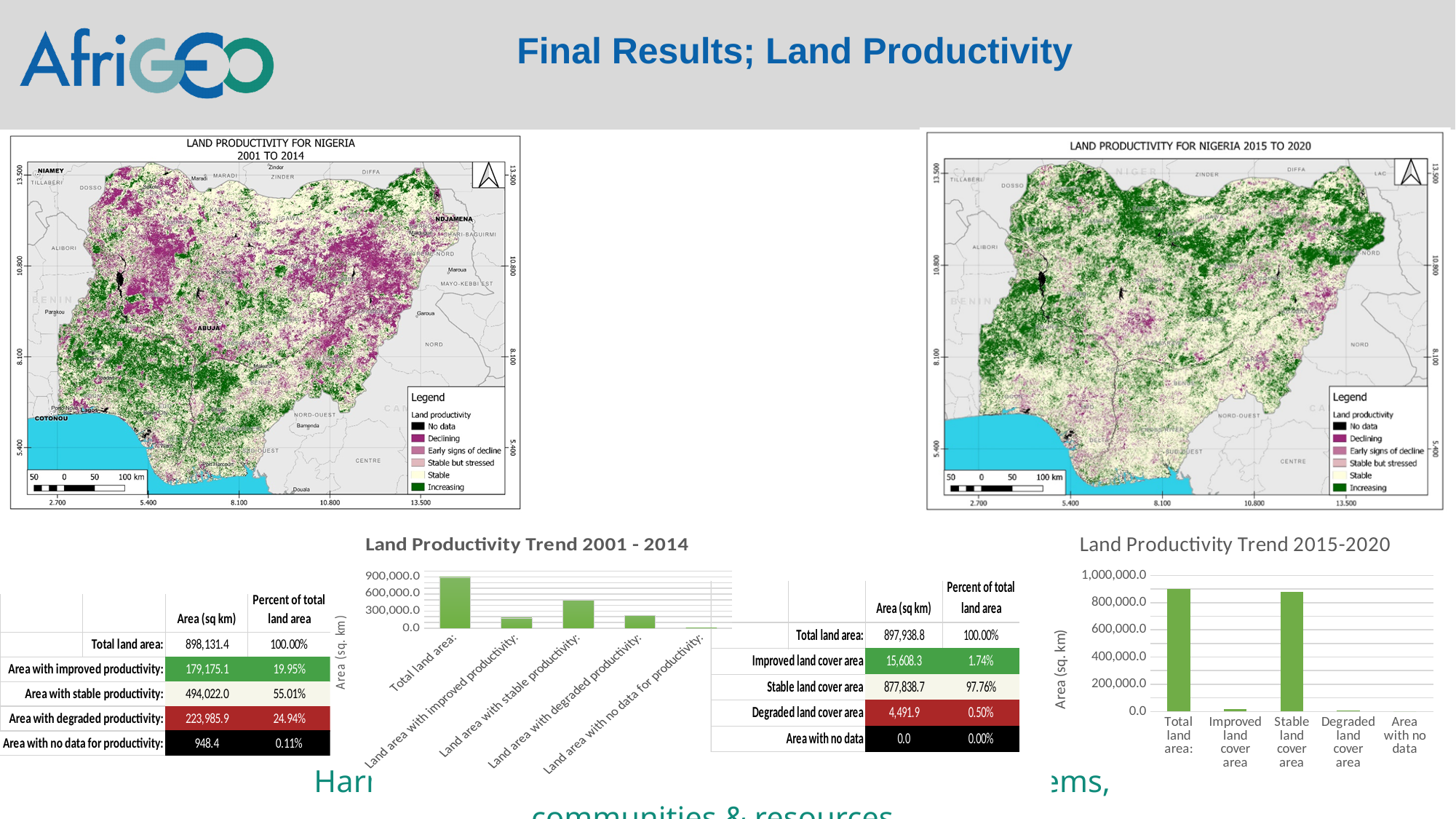
What is the y-axis label of the 'Land Productivity Trend 2001 - 2014' chart? Area (sq. km) In the 'Land Productivity Trend 2015-2020' chart, is the value for 'Improved land cover area' greater or less than 200,000.0? less In the 'Land Productivity Trend 2001 - 2014' chart, is the value for 'Land area with stable productivity' greater or less than 300,000.0? greater In the 'Land Productivity Trend 2015-2020' chart, is the value for 'Stable land cover area' greater or less than 800,000.0? greater In the 'Land Productivity Trend 2001 - 2014' chart, which category has the shortest bar? Land area with no data for productivity What type of chart is the 'Land Productivity Trend 2001 - 2014' chart? bar chart In the 'Land Productivity Trend 2001 - 2014' chart, which is larger: 'Land area with stable productivity' or 'Land area with improved productivity'? Land area with stable productivity How many categories are shown on the x axis of the 'Land Productivity Trend 2001 - 2014' chart? 5 In the 'Land Productivity Trend 2015-2020' chart, which is larger: 'Stable land cover area' or 'Improved land cover area'? Stable land cover area How many categories are shown on the x axis of the 'Land Productivity Trend 2015-2020' chart? 5 In the 'Land Productivity Trend 2001 - 2014' chart, which category has the tallest bar? Total land area